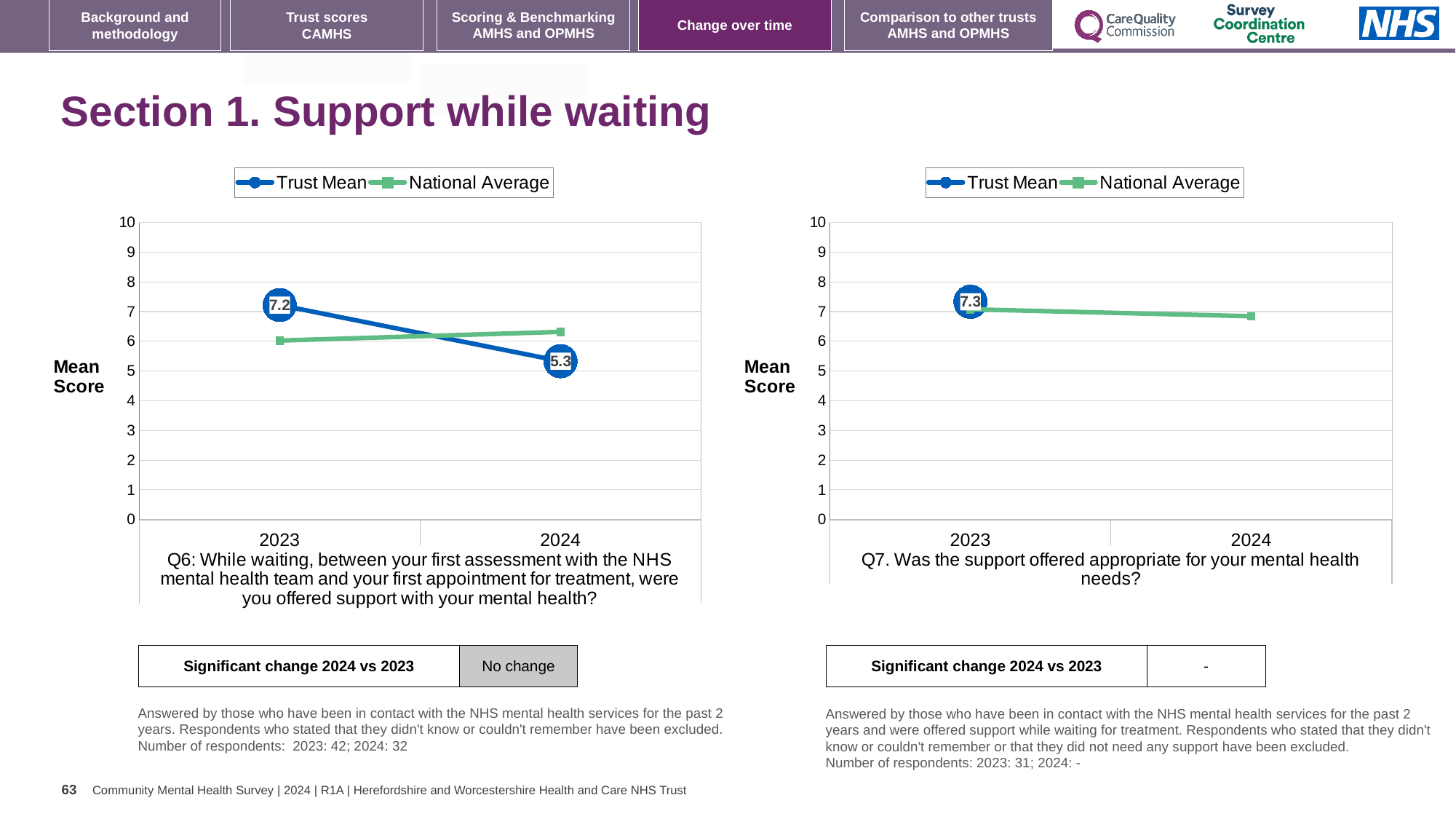
In the left chart (Q6), what is the Trust Mean score for 2023? 7.2 In the left chart (Q6), does the Trust Mean rise or fall from 2023 to 2024? fall In the left chart (Q6), by how much did the Trust Mean fall from 2023 to 2024? 1.9 In the right chart (Q7), what is the Trust Mean score for 2023? 7.3 In the left chart (Q6), which is larger in 2023: the Trust Mean or the National Average? Trust Mean What kind of chart is the right chart (Q7)? line chart What are the two legend entries in the right chart (Q7)? Trust Mean and National Average In the right chart (Q7), is the National Average for 2024 greater or less than 6? greater How many series does the legend of the left chart (Q6) list? 2 How many years are shown on the x axis of the left chart (Q6)? 2 In the left chart (Q6), what is the Trust Mean score for 2024? 5.3 In the left chart (Q6), is the National Average for 2023 greater or less than 7? less